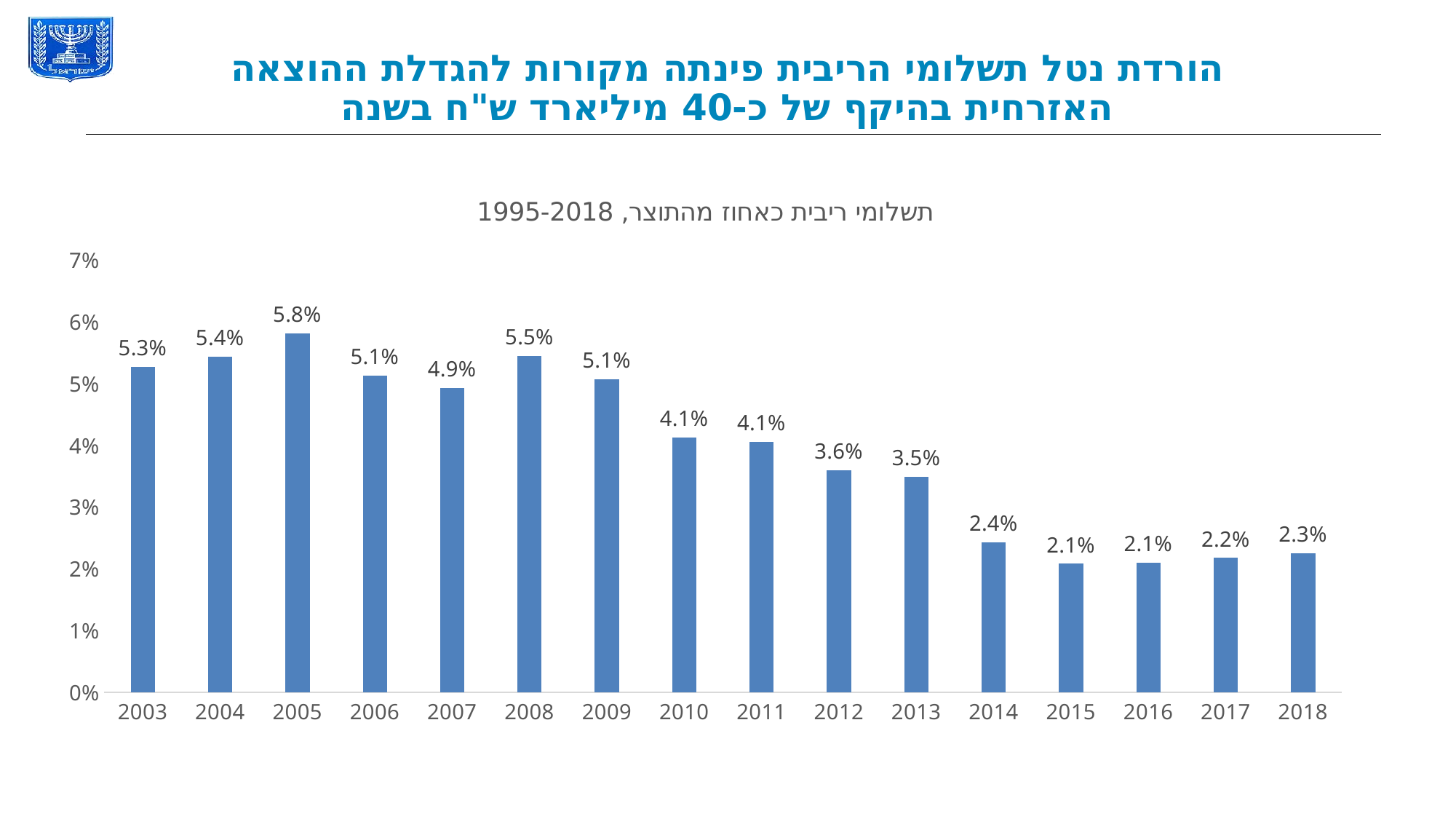
What is the value for 2012? 3.6% Is the value for 2010 greater or less than 4%? greater What is the value for 2018? 2.3% Do the values generally rise or fall from 2003 to 2018? fall What kind of chart is shown on the slide? bar chart What is the difference between the values for 2013 and 2014? 1.1% What is the difference between the values for 2005 and 2018? 3.5% What is the value for 2005? 5.8% What is the highest value shown on the y axis? 7% Which year has the highest value? 2005 Which is larger, the value for 2008 or the value for 2009? 2008 How many years are shown on the x axis? 16